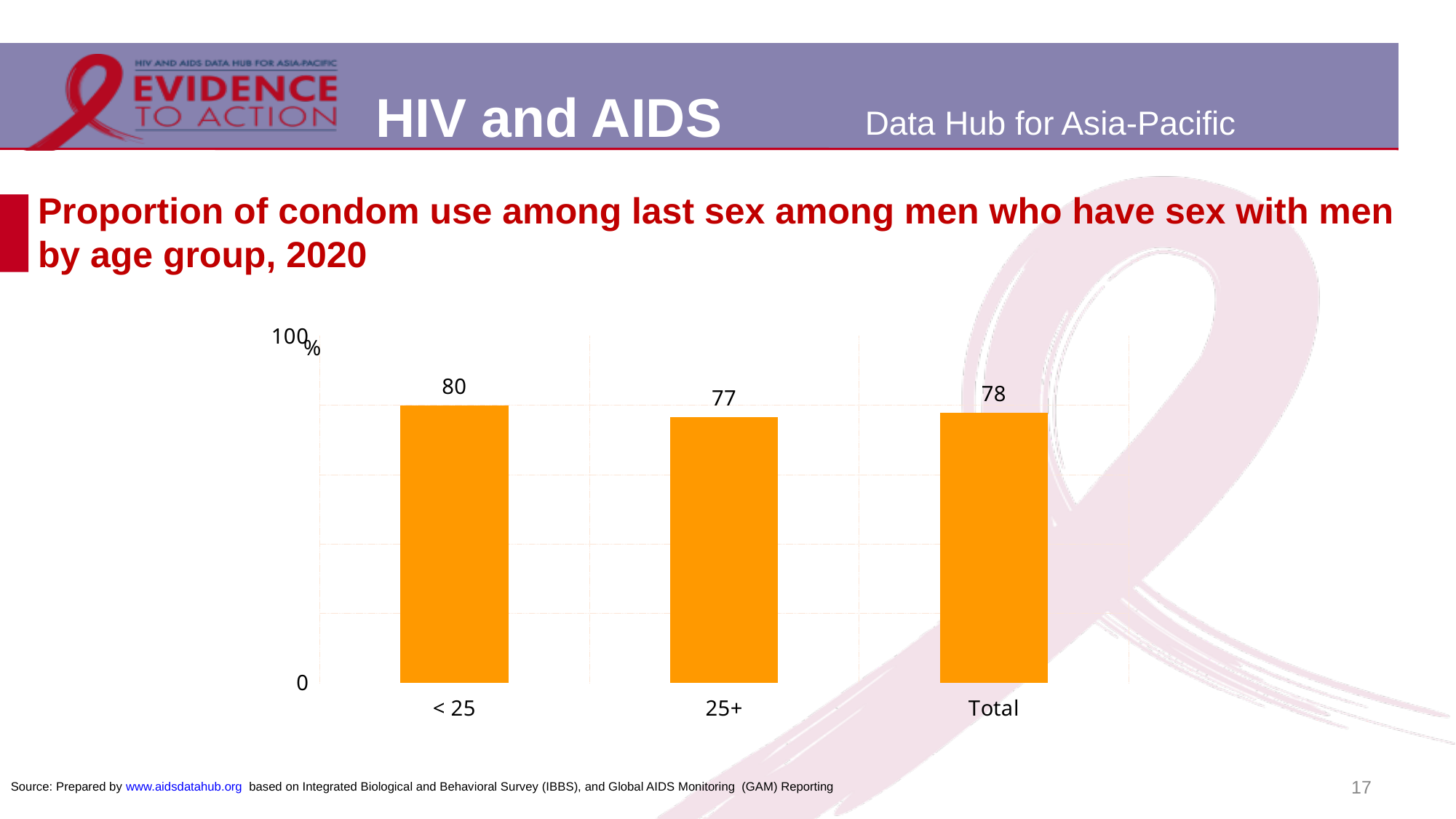
What is the value for Total? 78 Is the value for 25+ greater or less than 100? less What kind of chart is shown on the slide? bar chart Which category has the lowest value? 25+ What is the maximum value shown on the y axis? 100 Which category has the highest value? < 25 What is the value for the < 25 age group? 80 Which is larger, the value for < 25 or the value for Total? < 25 What year does the chart title refer to? 2020 What is the value for the 25+ age group? 77 How many categories are shown on the x axis? 3 What is the difference between the values for < 25 and 25+? 3